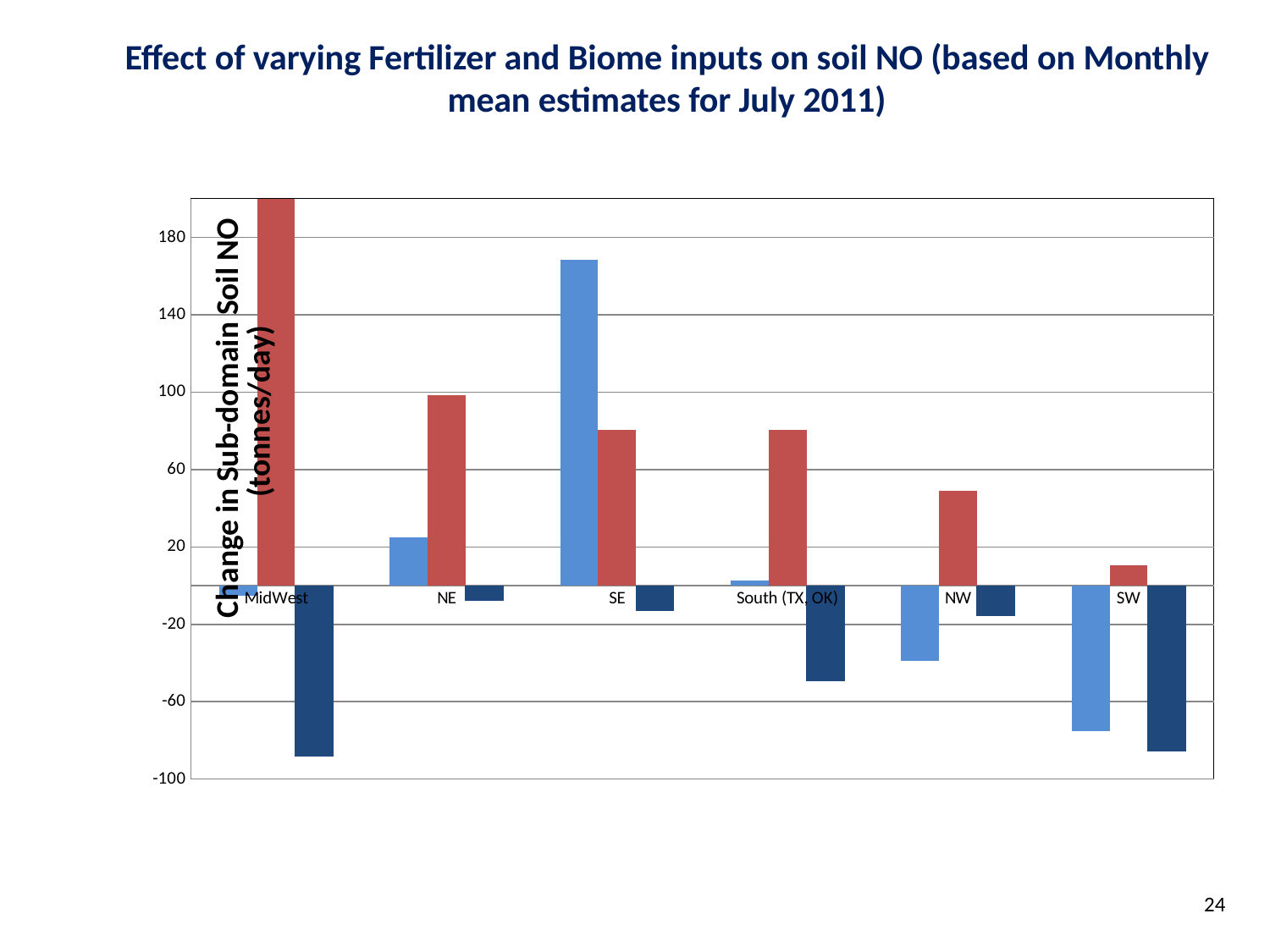
Which region has the tallest light blue bar? SE Is the light blue bar for SW greater or less than -60? less Is the light blue bar for SE greater or less than 140? greater How many bars are plotted for each region in the chart? 3 What is the label on the vertical axis of the chart? Change in Sub-domain Soil NO (tonnes/day) Which region has the lowest (most negative) light blue bar? SW How many regions (categories) are shown on the x axis of the chart? 6 Which region has the larger red bar, NE or NW? NE Which region has the tallest red bar? MidWest What kind of chart is shown on the slide? bar chart Is the red bar for MidWest greater or less than 180? greater